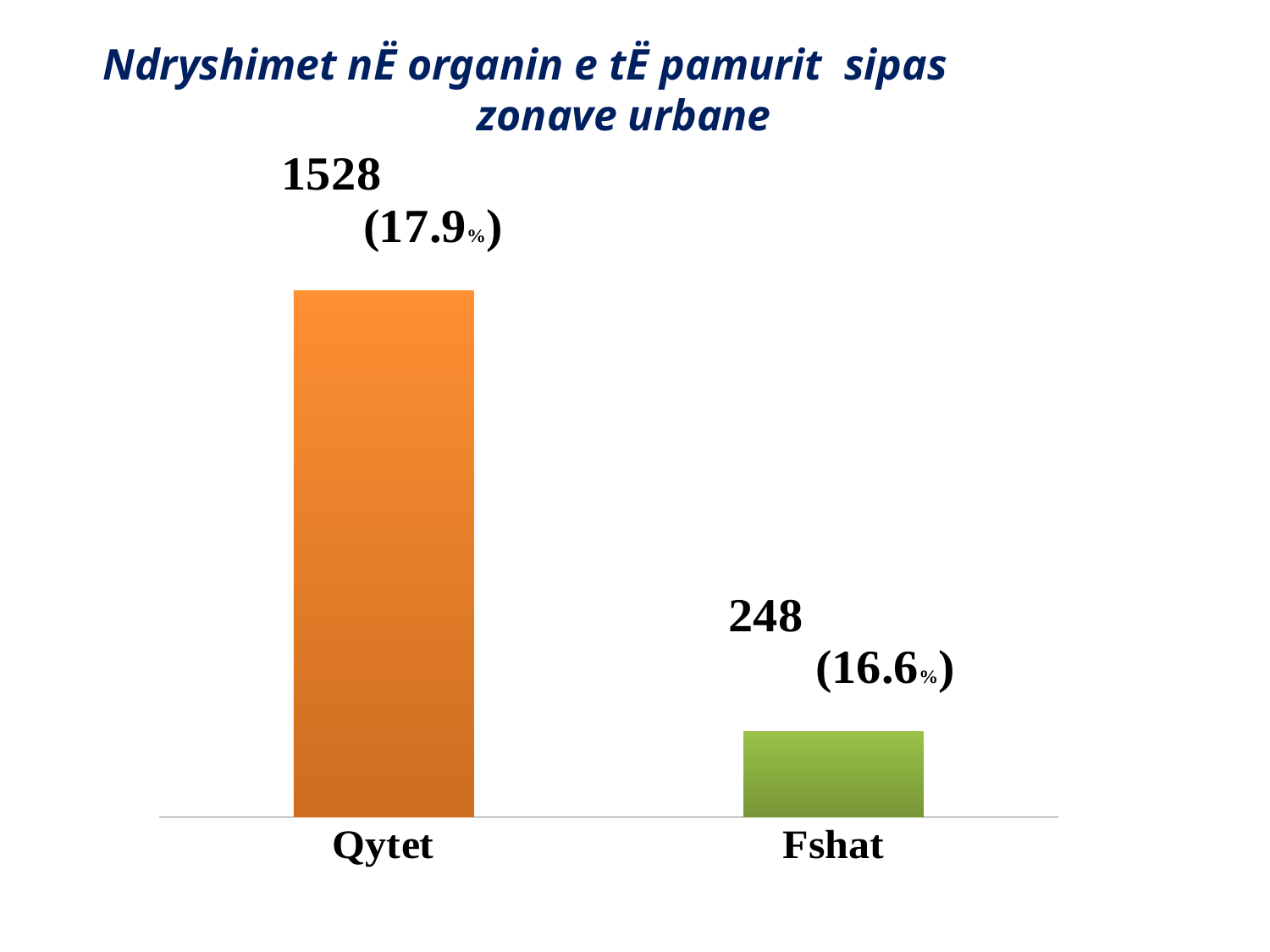
What percentage is shown in parentheses for Qytet? 17.9% What colour is the bar for Fshat? Green What is the value for Qytet? 1528 What kind of chart is shown on the slide? Bar chart How many categories are shown on the chart? 2 What percentage is shown in parentheses for Fshat? 16.6% What is the title of the chart? Ndryshimet nË organin e tË pamurit sipas zonave urbane What is the value for Fshat? 248 Which category has the highest value? Qytet Which is larger, the value for Qytet or the value for Fshat? Qytet What is the difference between the values for Qytet and Fshat? 1280 Which category has the lowest value? Fshat